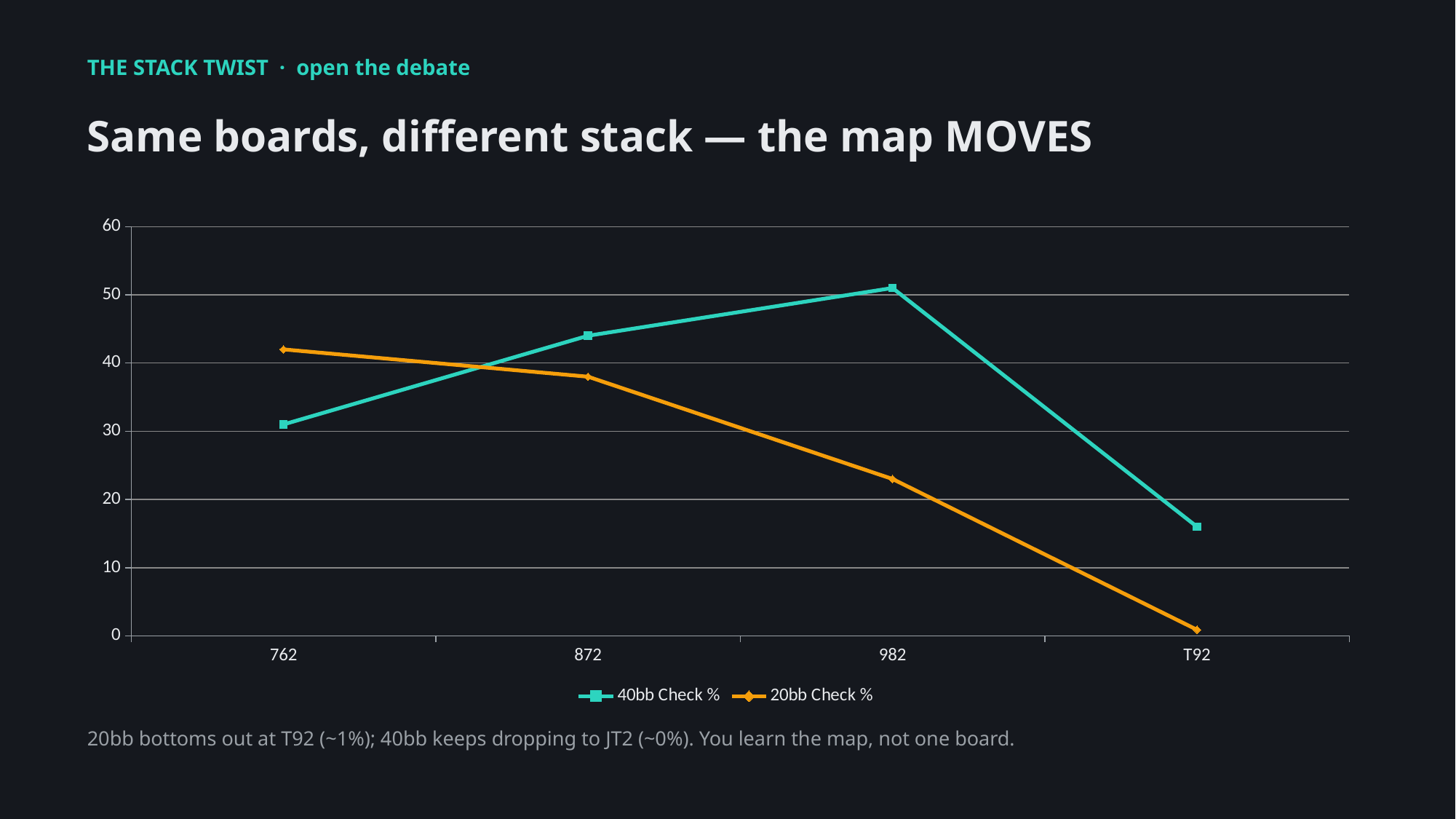
At which category does the 40bb Check % series reach its highest value? 982 Does the 20bb Check % series rise or fall from 762 to T92? fall Is the value for 40bb Check % at 762 greater or less than 40? less Is the value for 20bb Check % at 982 greater or less than 30? less At 982, which series has the higher value, 40bb Check % or 20bb Check %? 40bb Check % How many categories are plotted along the x axis? 4 At which category is the 20bb Check % series lowest? T92 At which category is the 20bb Check % series highest? 762 How many series does the legend list? 2 What is the title of the slide containing the chart? Same boards, different stack — the map MOVES What kind of chart is shown on the slide? line chart At 762, which series has the higher value, 40bb Check % or 20bb Check %? 20bb Check %